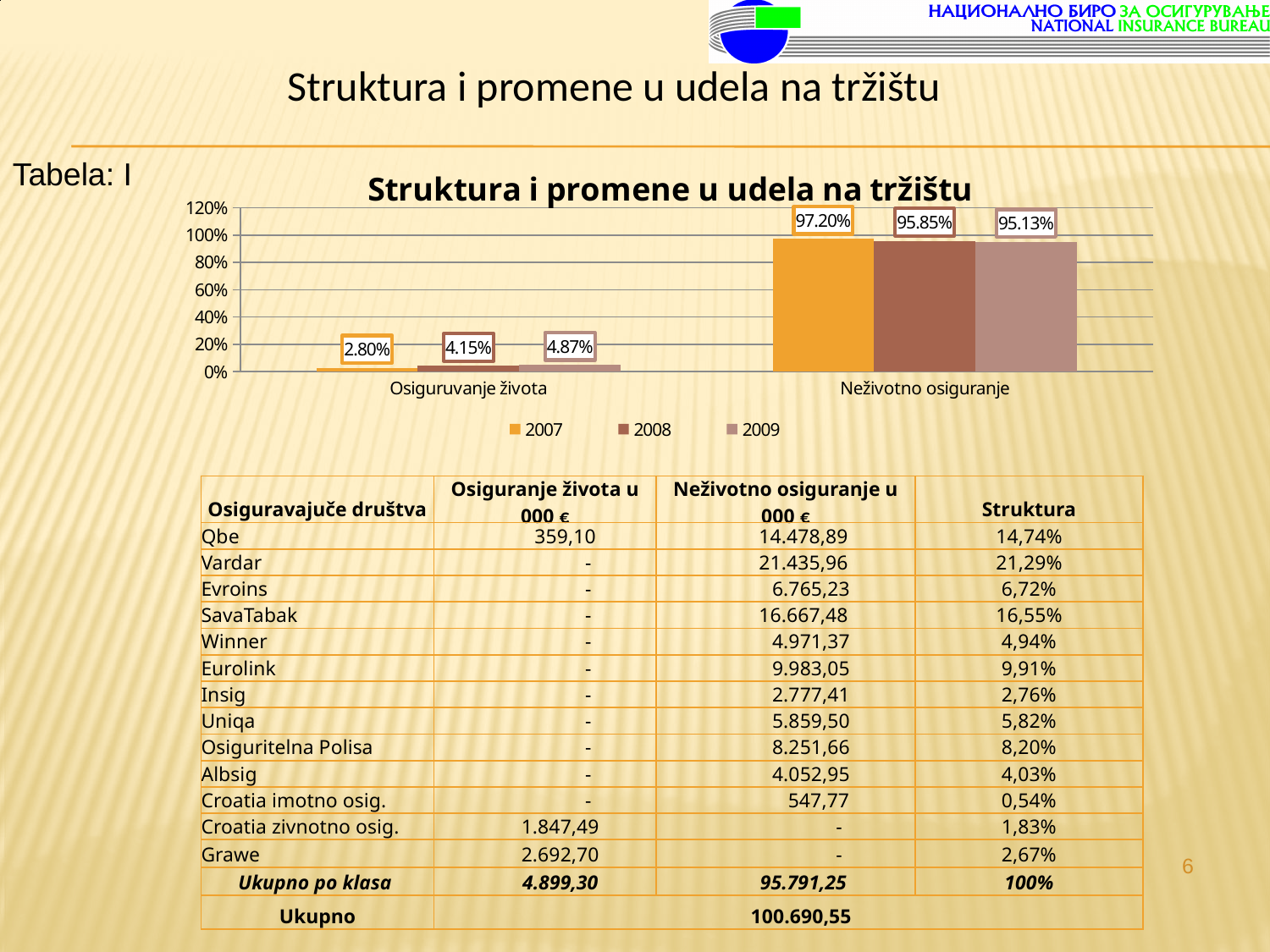
What is the value for 2007 in the Osiguruvanje života category? 2.80% What is the difference between the 2009 and 2007 values in the Osiguruvanje života category? 2.07% What type of chart is shown on the slide? bar chart How many categories are shown on the x axis of the chart? 2 Which is larger: the 2008 value for Neživotno osiguranje or the 2009 value for Neživotno osiguranje? 2008 Which year has the highest value in the Osiguruvanje života category? 2009 What is the value for 2008 in the Osiguruvanje života category? 4.15% Which year has the lowest value in the Neživotno osiguranje category? 2009 What is the value for 2007 in the Neživotno osiguranje category? 97.20% How many series does the chart legend list? 3 Do the values for Neživotno osiguranje rise or fall from 2007 to 2009? fall What is the value for 2009 in the Neživotno osiguranje category? 95.13%